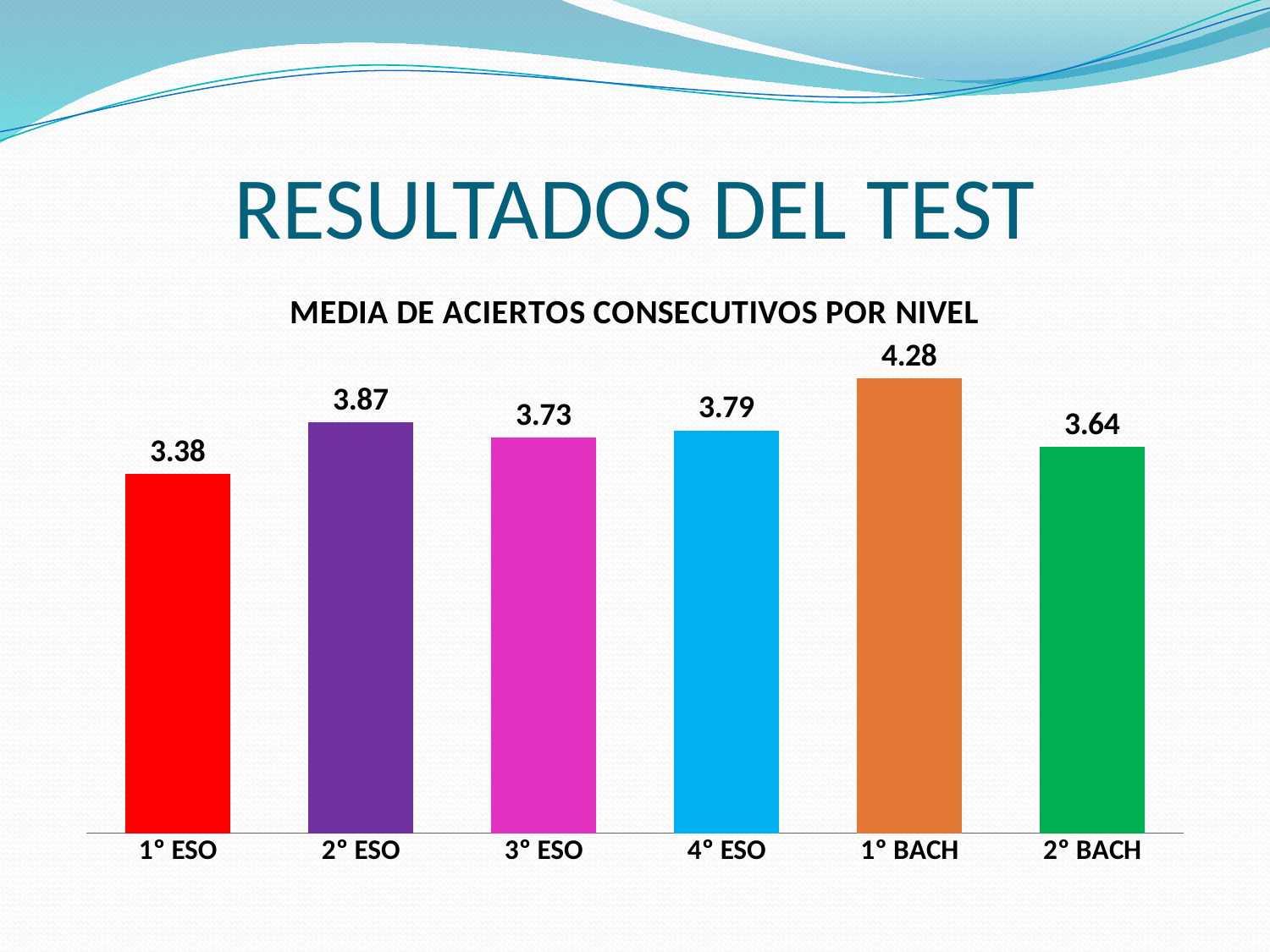
Which level has the highest value? 1° BACH What kind of chart is shown on the slide? Bar chart Which is larger, the value for 2° ESO or the value for 4° ESO? 2° ESO What is the difference between the values for 1° BACH and 1° ESO? 0.90 What is the value for 3° ESO? 3.73 Which level has the lowest value? 1° ESO What is the difference between the values for 2° ESO and 2° BACH? 0.23 What is the value for 1° ESO? 3.38 What is the value for 1° BACH? 4.28 Which is larger, the value for 2° BACH or the value for 1° ESO? 2° BACH How many levels are shown on the chart? 6 What is the title of the chart? MEDIA DE ACIERTOS CONSECUTIVOS POR NIVEL